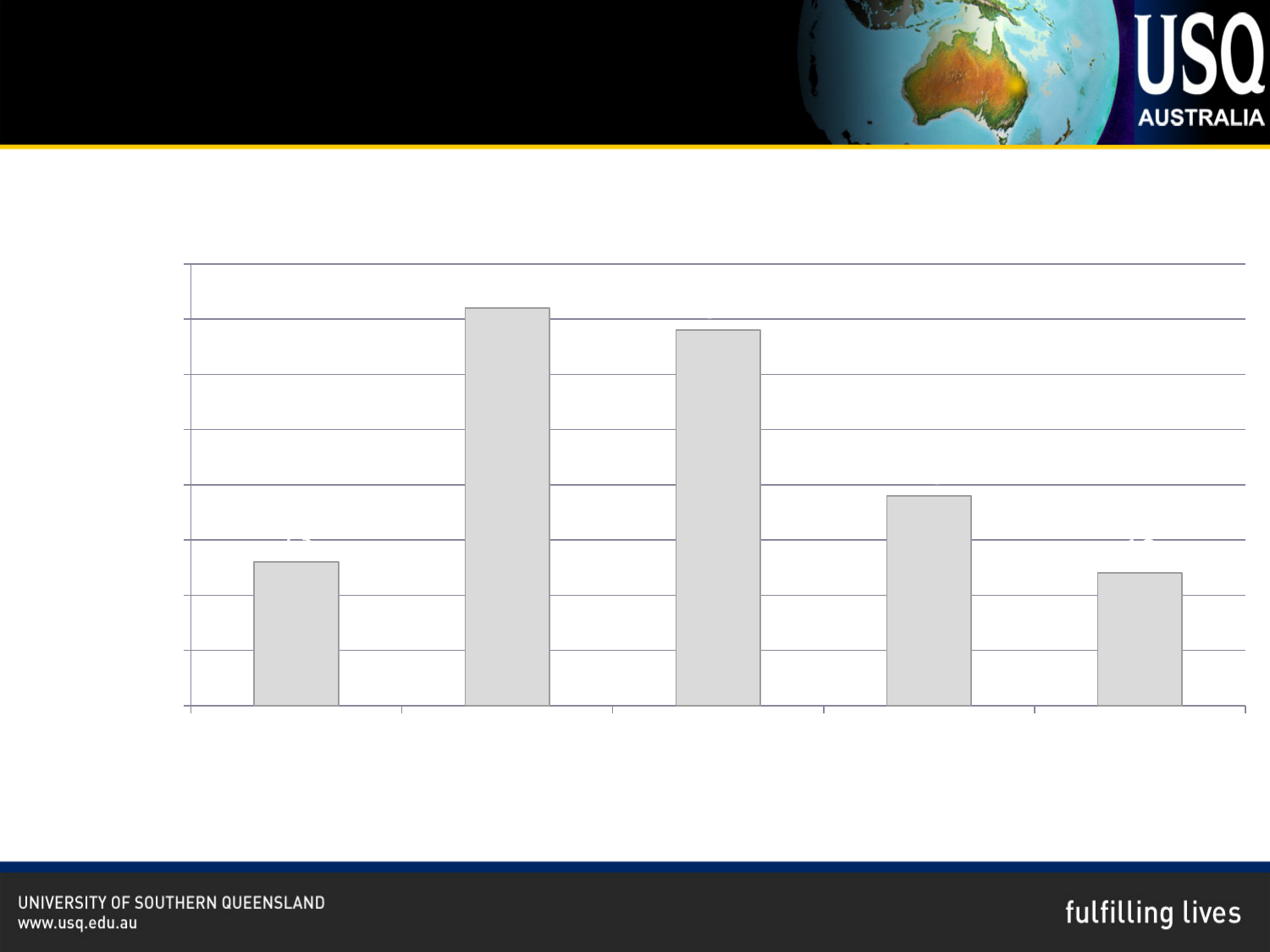
How many bars are plotted in the chart? 5 Which is taller, the first bar from the left or the fourth bar from the left? the fourth bar What kind of chart is shown on the slide? bar chart Which bar is the tallest in the chart, counting from the left? the second bar Which is taller, the second bar from the left or the fifth bar from the left? the second bar What colour are the bars in the chart? light grey Which is taller, the third bar from the left or the fourth bar from the left? the third bar